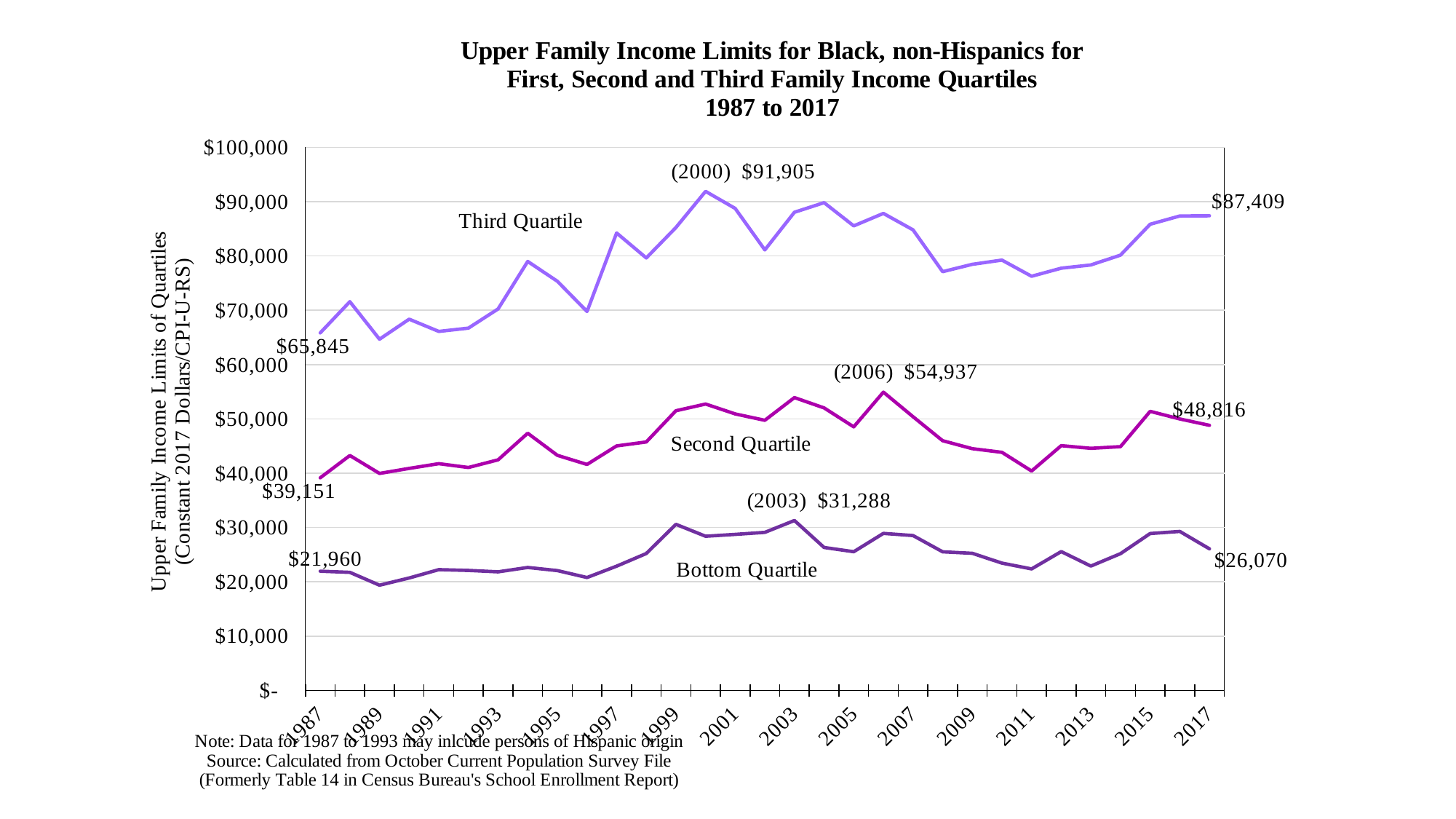
How many lines (series) are plotted on the chart? 3 What is the difference between the Second Quartile value in 2017 and in 1987? $9,665 What is the Second Quartile upper family income limit in 2006? $54,937 What is the Bottom Quartile upper family income limit in 2017? $26,070 Is the Third Quartile value in 2011 greater or less than $80,000? less What is the Third Quartile upper family income limit in 1987? $65,845 In which year does the Bottom Quartile line reach its peak? 2003 What type of chart is shown on the slide? Line chart How much higher is the Third Quartile value in 2017 than in 1987? $21,564 Does the Second Quartile line rise or fall from 1987 to 2017 overall? rise What is the Third Quartile upper family income limit in 2000? $91,905 Which is larger: the Bottom Quartile value in 2003 or in 2017? 2003